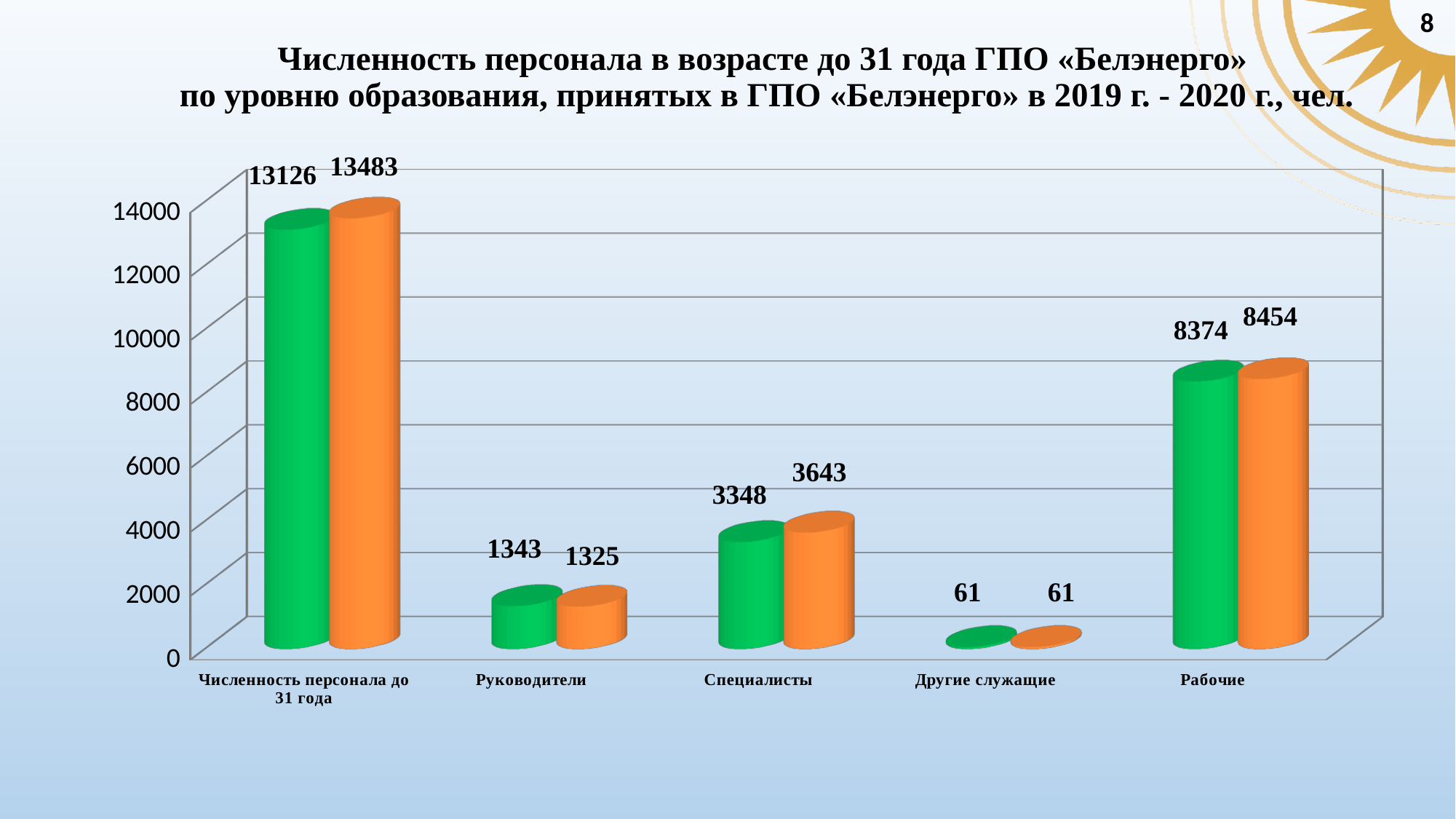
What is the value of the green bar for Специалисты? 3348 What is the difference between the orange and green bars for Специалисты? 295 For Руководители, which bar is larger, the green one or the orange one? green Is the value of the green bar for Рабочие greater or less than 8000? greater What is the value of the orange bar for Руководители? 1325 What is the maximum value shown on the vertical axis? 14000 Which category has the lowest orange bar? Другие служащие Which category has the highest green bar? Численность персонала до 31 года What is the value of the orange bar for Рабочие? 8454 What is the difference between the orange and green bars for Численность персонала до 31 года? 357 How many categories are shown on the x axis? 5 What kind of chart is shown on the slide? bar chart